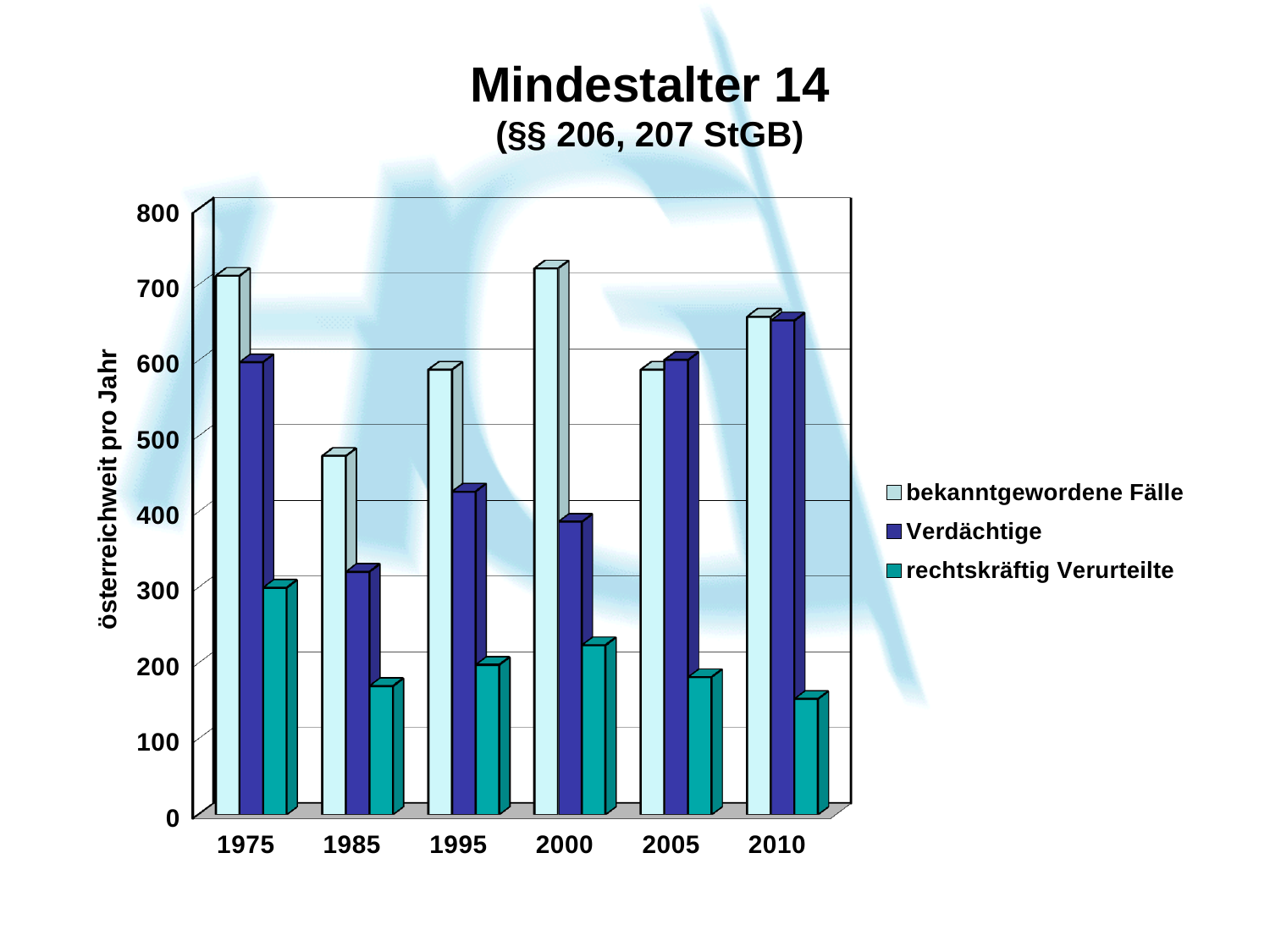
Which year has the highest value for rechtskräftig Verurteilte? 1975 Which is larger: Verdächtige in 1995 or Verdächtige in 2000? 1995 Do the values for Verdächtige rise or fall from 2000 to 2010? rise Which year has the lowest value for bekanntgewordene Fälle? 1985 Which year has the highest value for Verdächtige? 2010 Is the value for bekanntgewordene Fälle in 1985 greater or less than 500? less What is the label of the vertical axis? österreichweit pro Jahr How many series does the legend list? 3 Is the value for bekanntgewordene Fälle in 1975 greater or less than 600? greater How many years are shown on the x axis? 6 Is the value for rechtskräftig Verurteilte in 2010 greater or less than 200? less What kind of chart is shown on the slide? bar chart